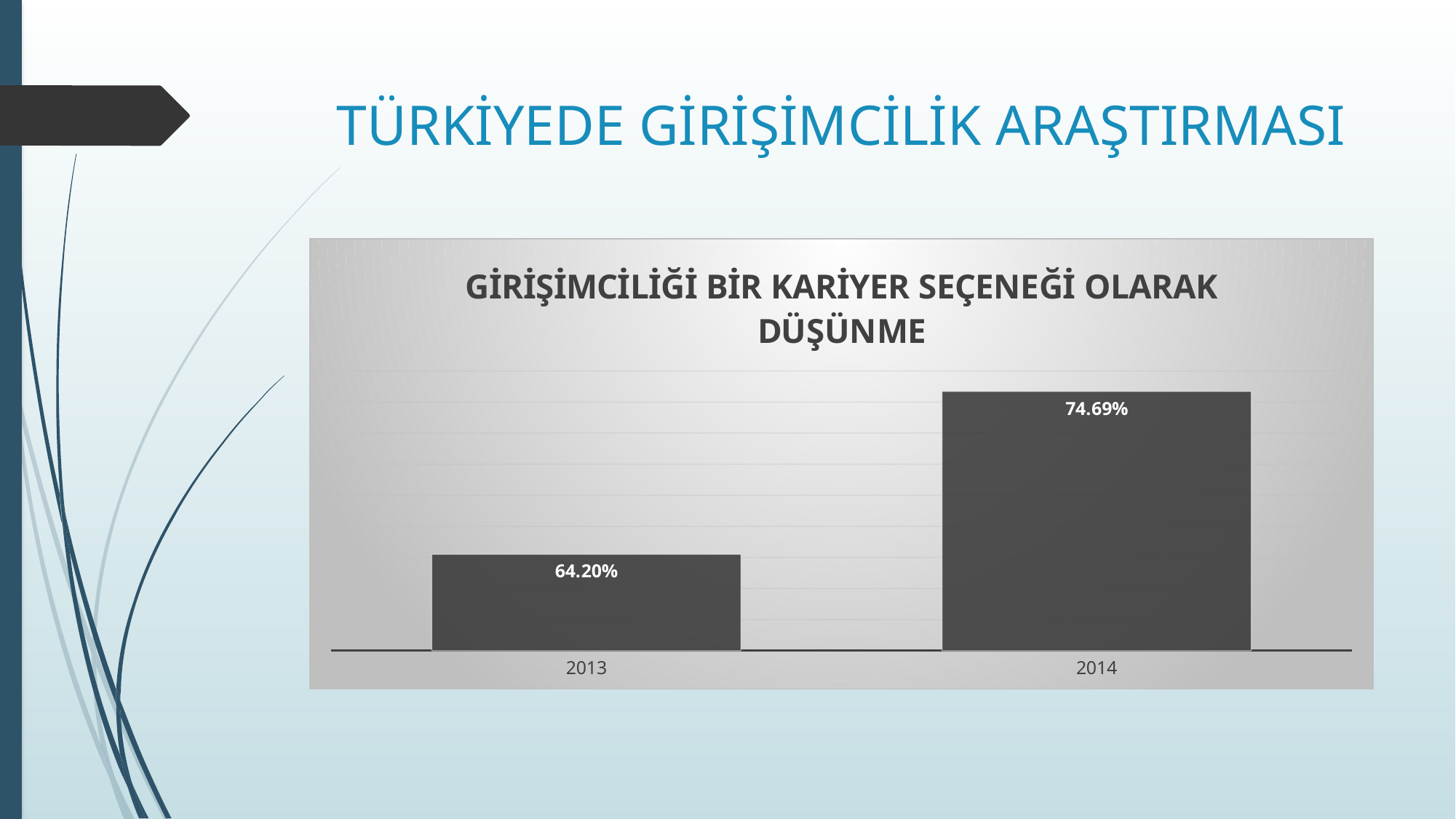
What kind of chart is shown on the slide? Bar chart Which year has the highest value? 2014 Which is larger, the value for 2013 or the value for 2014? 2014 How many categories are shown on the x axis? 2 Which year has the lowest value? 2013 What is the value for 2014? 74.69% What is the difference between the values for 2014 and 2013? 10.49% What is the title of the chart? GİRİŞİMCİLİĞİ BİR KARİYER SEÇENEĞİ OLARAK DÜŞÜNME What colour are the bars in the chart? Dark grey Do the values rise or fall from 2013 to 2014? Rise What is the value for 2013? 64.20%